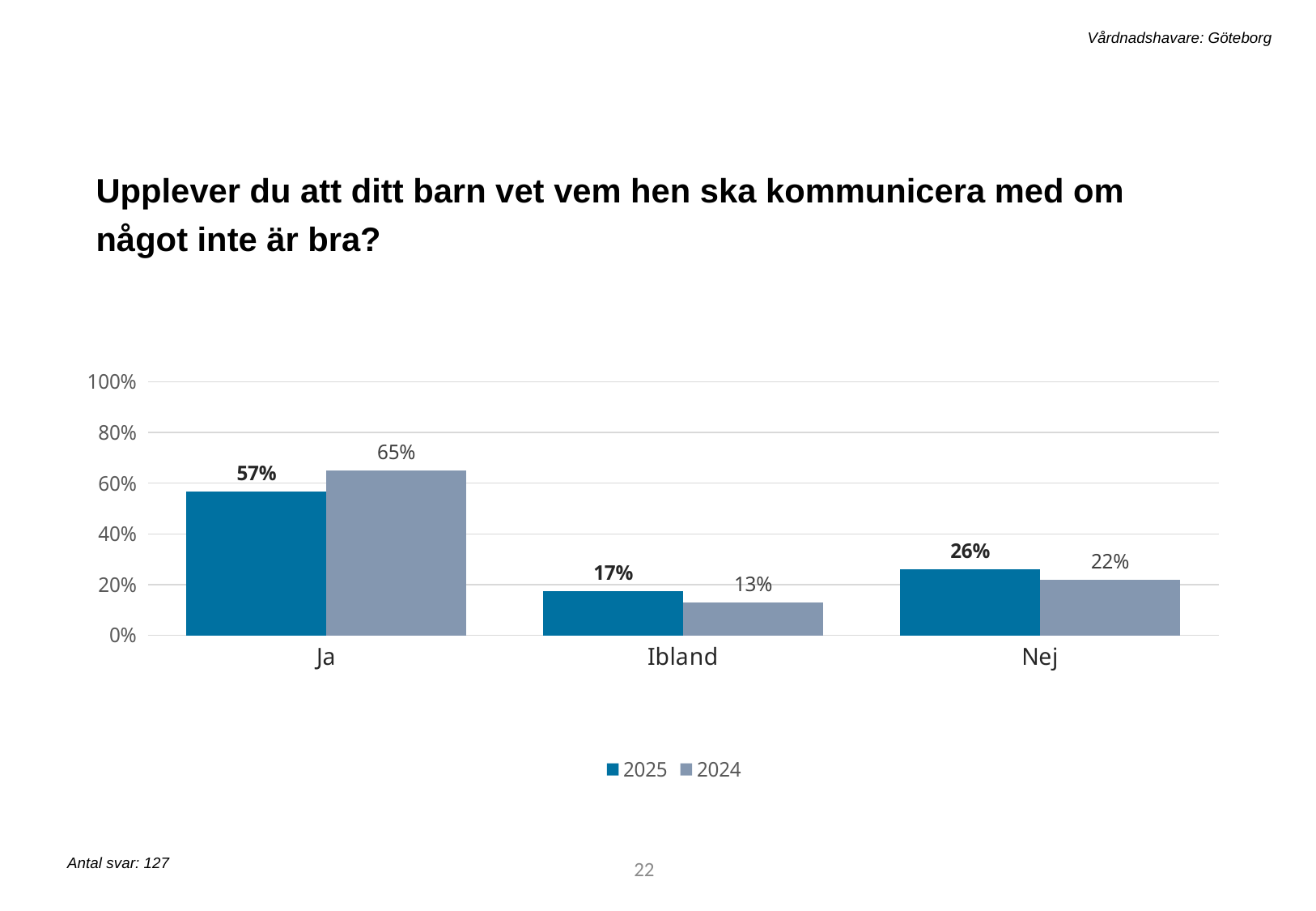
Is the 2024 value for Ja greater or less than 60%? greater How many categories are shown on the x axis? 3 Which category has the highest value in the 2025 series? Ja What is the value for Ibland in the 2025 series? 17% What is the value for Ja in the 2024 series? 65% Which is larger for Nej: the 2025 value or the 2024 value? 2025 What is the difference between the 2024 and 2025 values for Ja? 8% What kind of chart is shown on the slide? Bar chart How many series does the legend list? 2 Which category has the lowest value in the 2024 series? Ibland What is the value for Ja in the 2025 series? 57% What is the value for Nej in the 2024 series? 22%